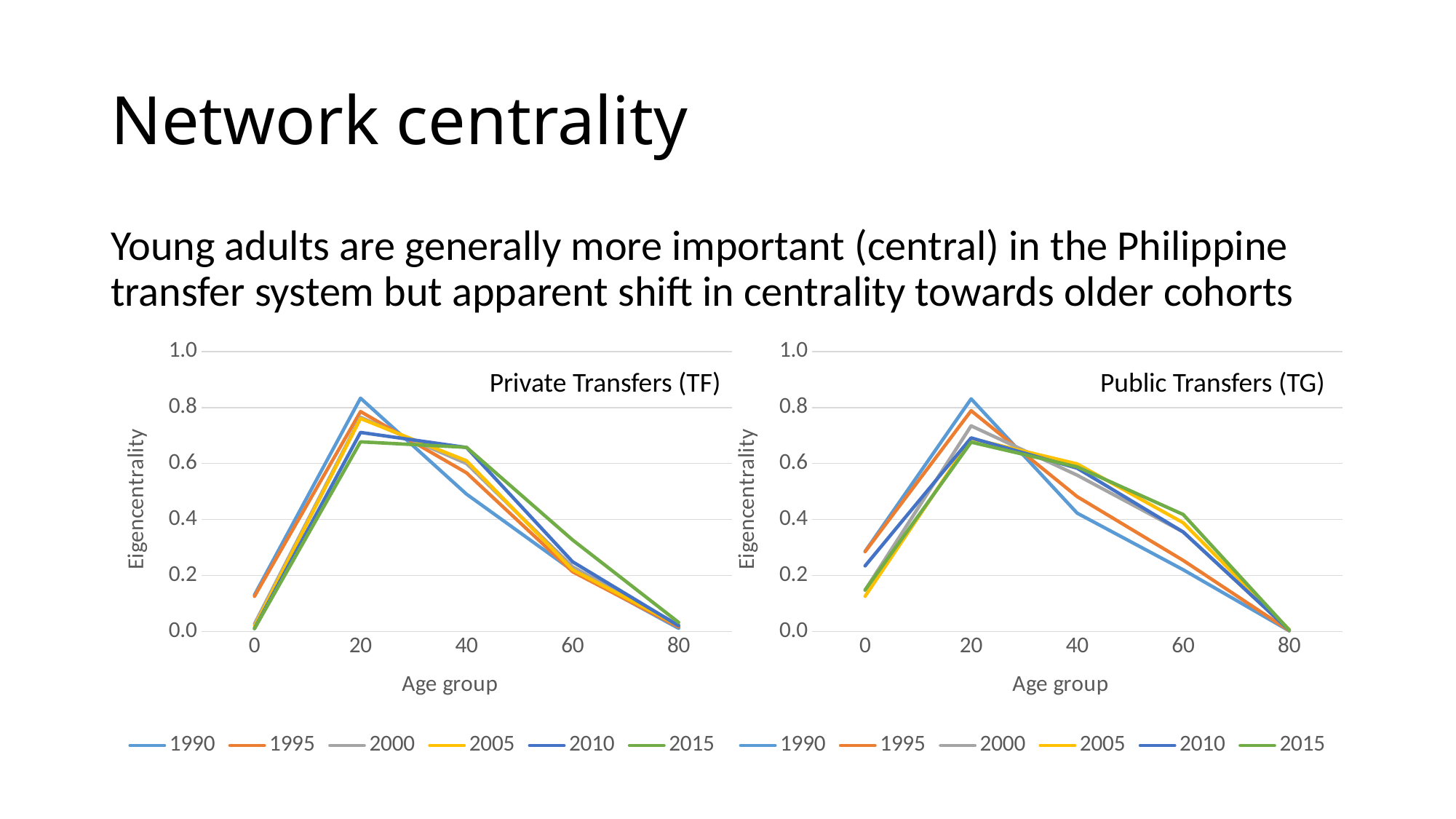
How many series does the legend of the Public Transfers (TG) chart list? 6 In the Private Transfers (TF) chart, is the value for 2015 at age group 20 greater or less than 0.8? less What type of chart is the Private Transfers (TF) chart? line chart How many age group points are plotted along the x axis of the Private Transfers (TF) chart? 5 In the Public Transfers (TG) chart, at age group 60, which is larger: the value for 1990 or the value for 2015? 2015 In the Private Transfers (TF) chart, is the value for 1990 at age group 20 greater or less than 0.8? greater In the Private Transfers (TF) chart, which series has the highest value at age group 20? 1990 In the Public Transfers (TG) chart, is the value for 1995 at age group 60 greater or less than 0.2? greater In the Private Transfers (TF) chart, at which age group does the 1990 series reach its highest value? 20 In the Public Transfers (TG) chart, do the values for the 1990 series rise or fall from age group 20 to age group 80? fall